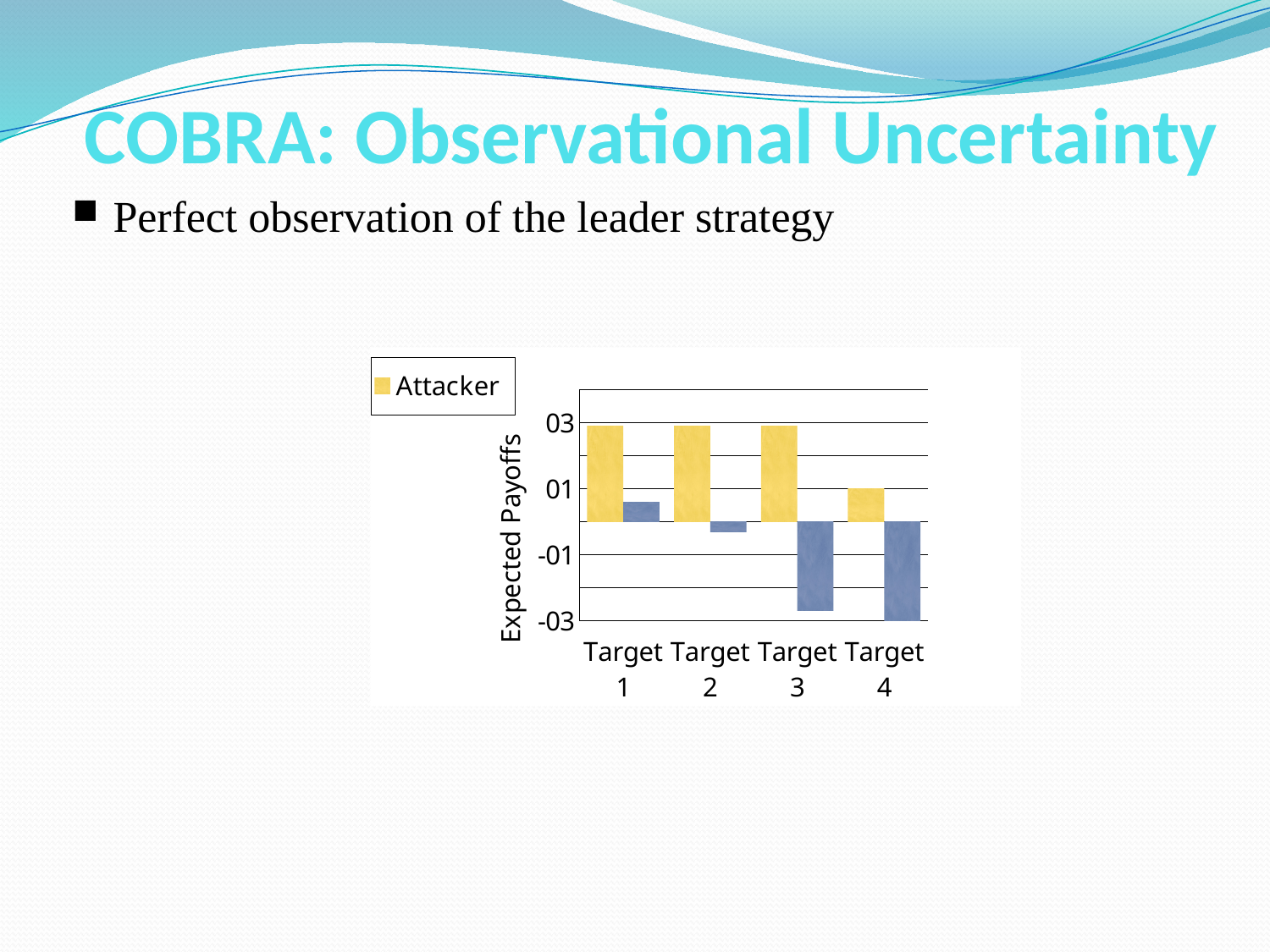
Is the Attacker value for Target 4 greater or less than 03? less How many categories are shown on the x axis of the chart? 4 Is the value of the blue bar for Target 3 greater or less than -01? less Which is larger, the blue bar for Target 1 or the blue bar for Target 4? Target 1 How many series does the chart's legend list? 1 Which target has the lowest Attacker value? Target 4 What is the label of the chart's vertical axis? Expected Payoffs Which is larger, the Attacker value for Target 1 or for Target 4? Target 1 What series name appears in the chart's legend? Attacker What kind of chart is shown on the slide? bar chart Is the value of the blue bar for Target 1 greater or less than -01? greater